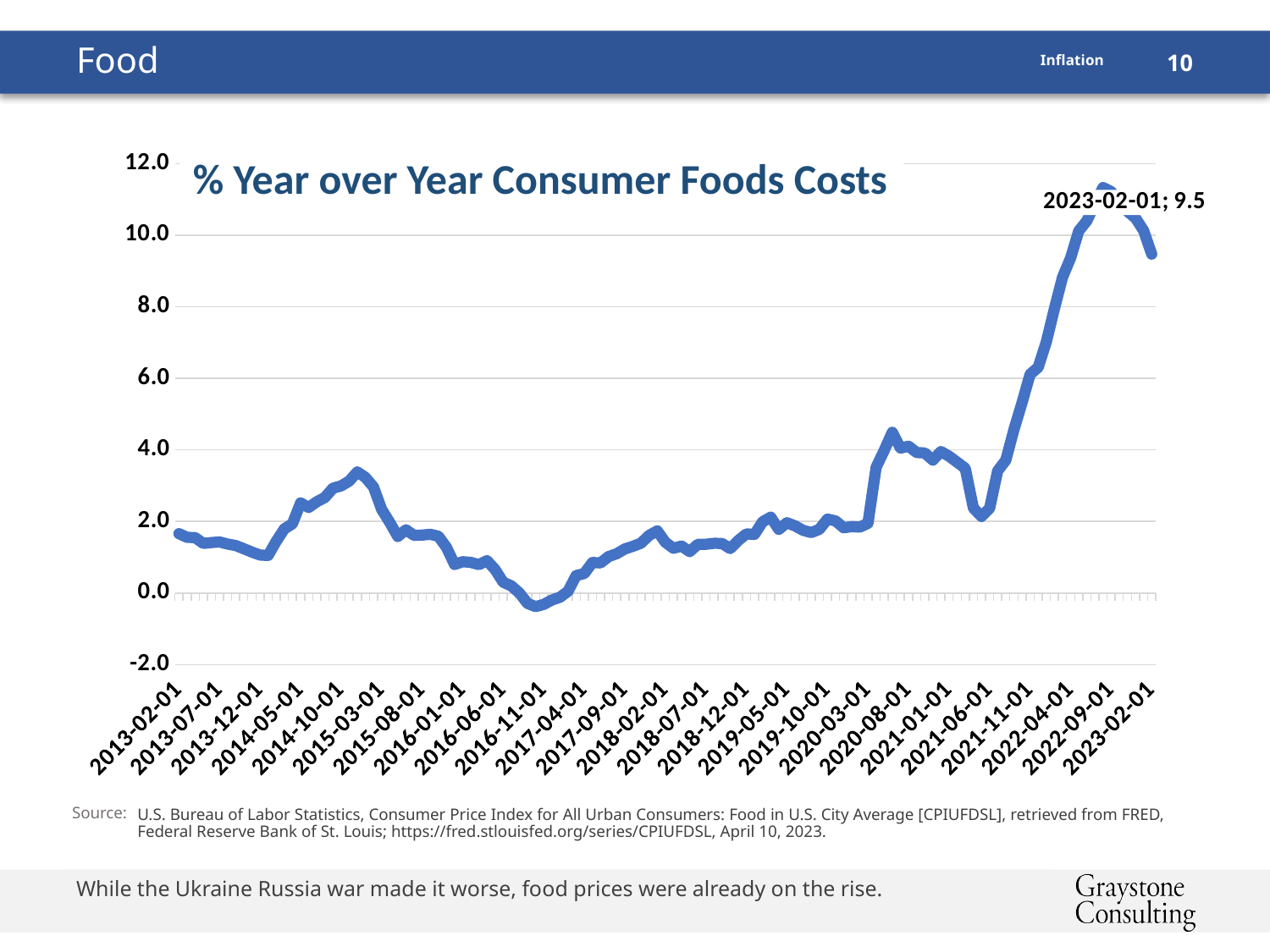
Is the value for 2023-02-01 greater or less than 8.0? greater Which is larger, the value for 2023-02-01 or the value for 2013-02-01? 2023-02-01 Does the line rise or fall between 2015-03-01 and 2016-11-01? fall Is the value for 2016-11-01 greater or less than 2.0? less How many data series are plotted on the chart? 1 What kind of chart is shown on the slide? Line chart Is the value for 2020-08-01 greater or less than 2.0? greater What value is labelled on the line for 2023-02-01? 9.5 What is the title of the chart? % Year over Year Consumer Foods Costs Does the line rise or fall between 2021-06-01 and 2022-09-01? rise